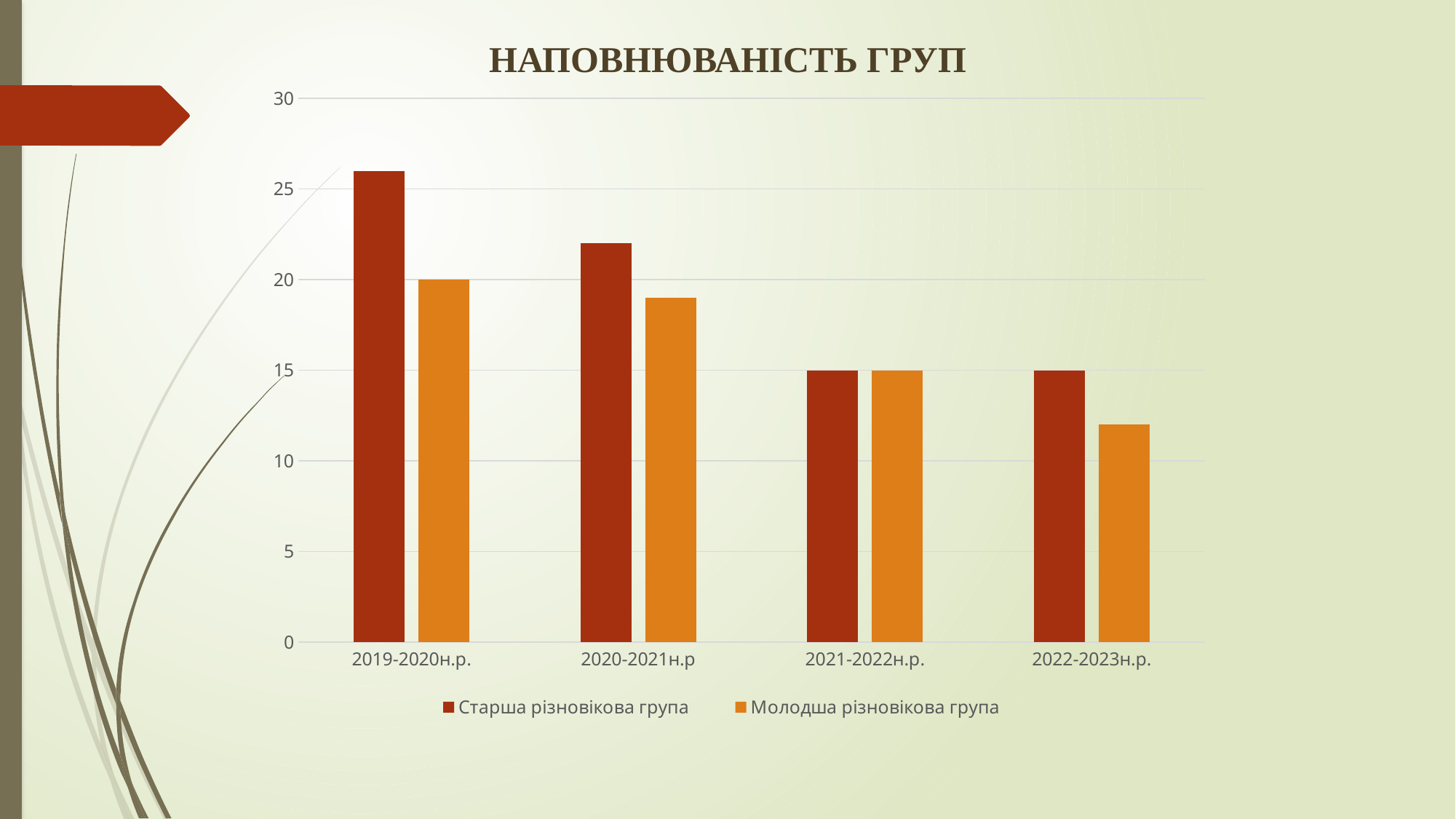
Is the value for Молодша різновікова група in 2022-2023н.р. greater or less than 15? less How many series does the legend list? 2 What is the value for Молодша різновікова група in 2021-2022н.р.? 15 In which year is the value for Молодша різновікова група lowest? 2022-2023н.р. In 2022-2023н.р., which series has the larger value, Старша різновікова група or Молодша різновікова група? Старша різновікова група What is the value for Старша різновікова група in 2021-2022н.р.? 15 What is the title of the chart? НАПОВНЮВАНІСТЬ ГРУП In which year is the value for Старша різновікова група highest? 2019-2020н.р. How many academic-year categories are shown on the x axis? 4 Is the value for Старша різновікова група in 2019-2020н.р. greater or less than 25? greater What is the value for Молодша різновікова група in 2019-2020н.р.? 20 What kind of chart is shown on the slide? bar chart